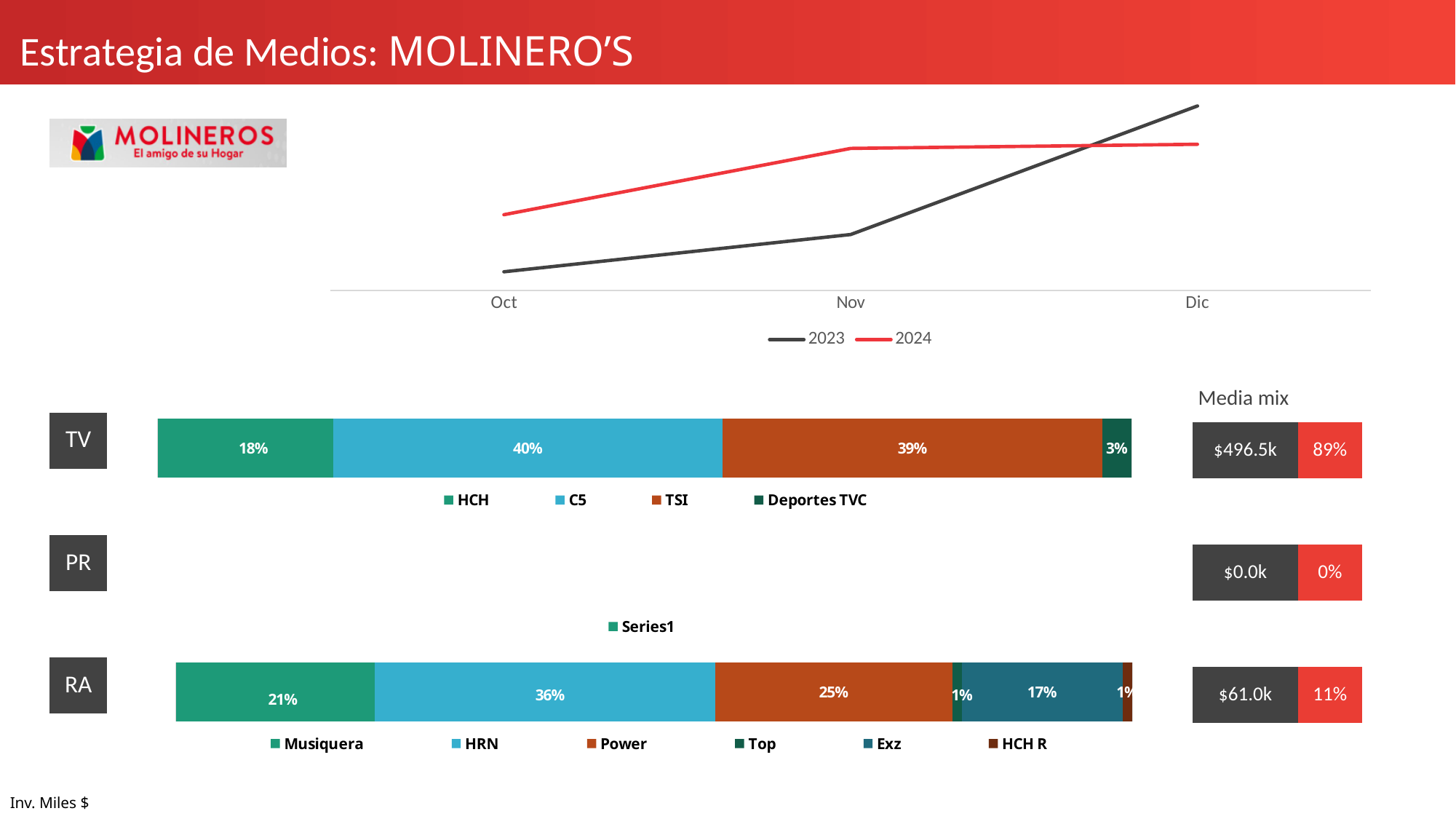
In the TV bar chart, what is the difference between the HCH share and the TSI share? 21% In the TV bar chart, what share does C5 have? 40% In the top line chart, does the 2023 line rise or fall from Oct to Dic? Rise In the top line chart, which series is higher in Dic, 2023 or 2024? 2023 In the top line chart, which series is higher in Oct, 2023 or 2024? 2024 In the RA bar chart, which station has the largest share? HRN In the TV bar chart, which channel has the smallest share? Deportes TVC In the Media mix column, what is the investment value shown for RA? $61.0k What type of chart is the top chart comparing 2023 and 2024? Line chart In the top line chart, how many months are shown on the x axis? 3 In the RA bar chart, how many stations does the legend list? 6 In the top line chart, how many series does the legend list? 2